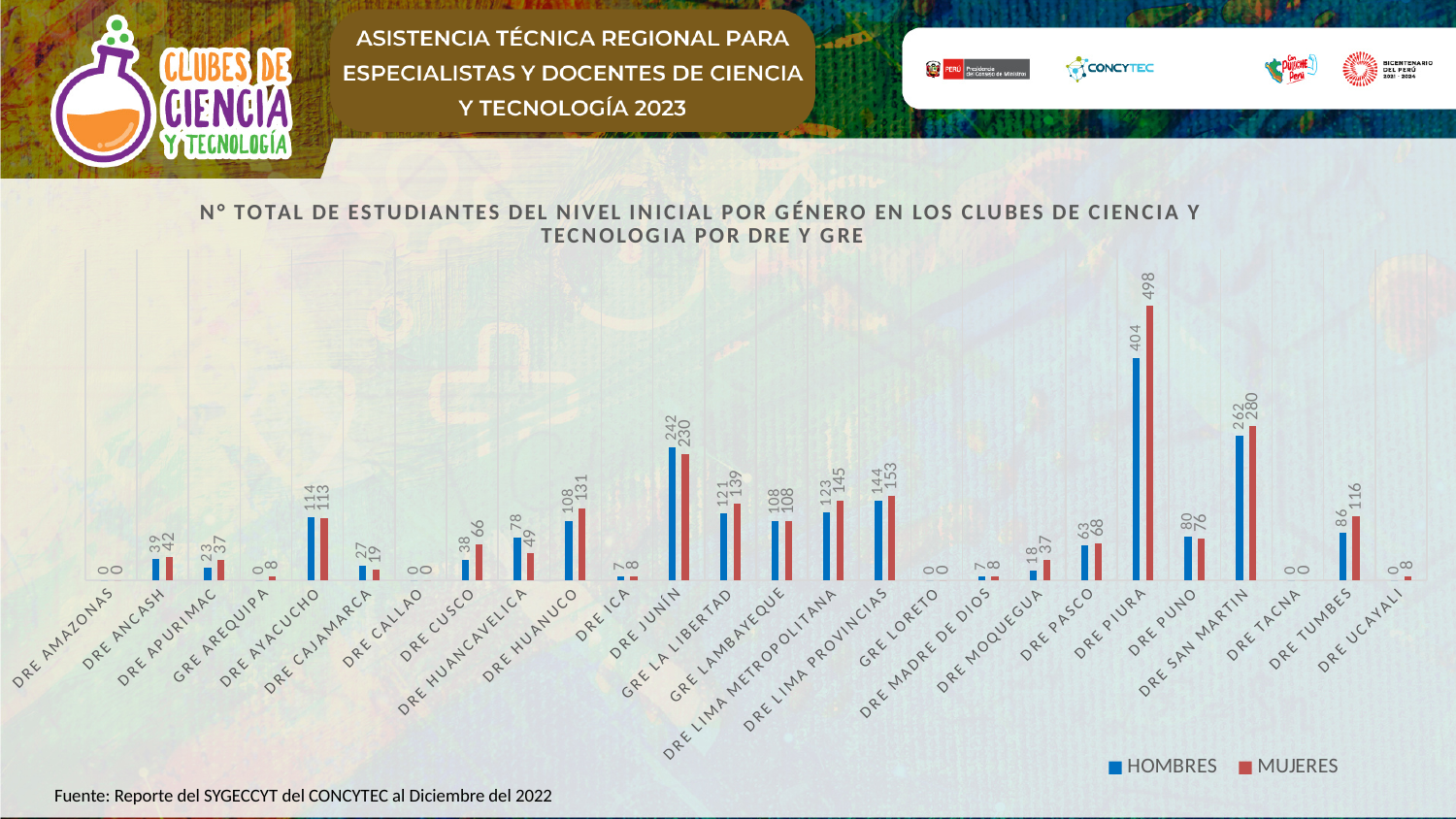
What is the value for HOMBRES in DRE JUNÍN? 242 What type of chart is shown on the slide? Bar chart Which is larger in DRE CUSCO, HOMBRES or MUJERES? MUJERES What colour represents the HOMBRES series? Blue How many series does the legend list? 2 Which region has the highest value for HOMBRES? DRE PIURA What is the difference between HOMBRES and MUJERES in DRE HUANCAVELICA? 29 What is the difference between MUJERES and HOMBRES in DRE PIURA? 94 What is the value for MUJERES in DRE PIURA? 498 What is the value for MUJERES in DRE HUANUCO? 131 How many regions (DRE/GRE) are shown on the x axis? 26 Which is larger in DRE SAN MARTIN, HOMBRES or MUJERES? MUJERES